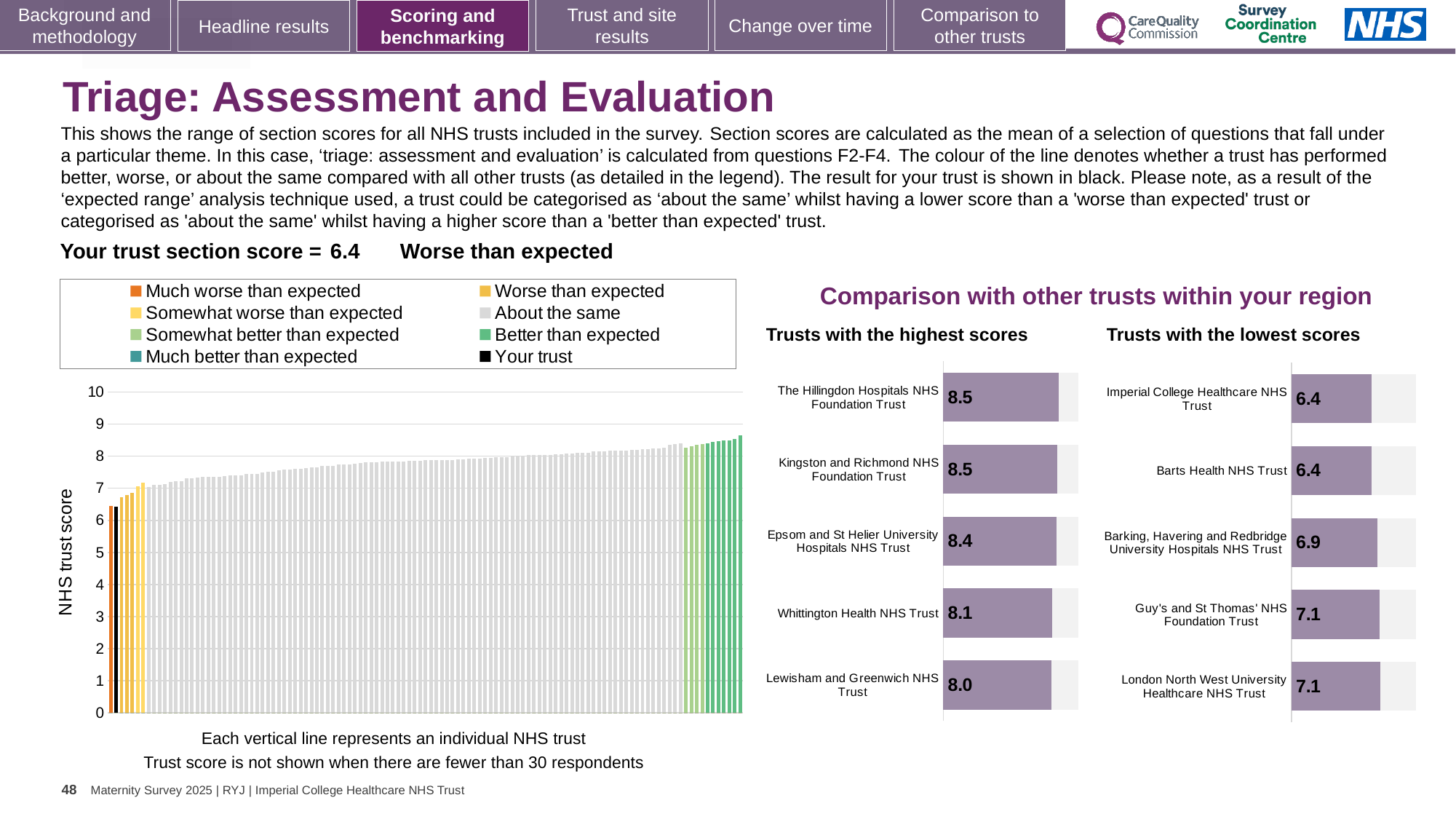
In the 'Trusts with the lowest scores' chart, which is larger: the score for Barking, Havering and Redbridge University Hospitals NHS Trust or the score for Barts Health NHS Trust? Barking, Havering and Redbridge University Hospitals NHS Trust In the 'Trusts with the highest scores' chart, what is the score for Whittington Health NHS Trust? 8.1 In the 'Trusts with the lowest scores' chart, what is the score for Guy's and St Thomas' NHS Foundation Trust? 7.1 In the 'Trusts with the highest scores' chart, which trust has the lowest score? Lewisham and Greenwich NHS Trust In the 'Trusts with the lowest scores' chart, what is the difference between the scores of London North West University Healthcare NHS Trust and Imperial College Healthcare NHS Trust? 0.7 In the large chart on the left, is the value of the black 'Your trust' bar greater or less than 7? less In the 'Trusts with the highest scores' chart, what is the difference between the scores of The Hillingdon Hospitals NHS Foundation Trust and Lewisham and Greenwich NHS Trust? 0.5 In the 'Trusts with the highest scores' chart, what is the score for The Hillingdon Hospitals NHS Foundation Trust? 8.5 How many entries does the legend of the large chart on the left list? 8 What kind of chart is the large chart on the left showing NHS trust scores? Bar chart How many trusts are shown in the 'Trusts with the highest scores' chart? 5 In the 'Trusts with the lowest scores' chart, what is the score for Barking, Havering and Redbridge University Hospitals NHS Trust? 6.9